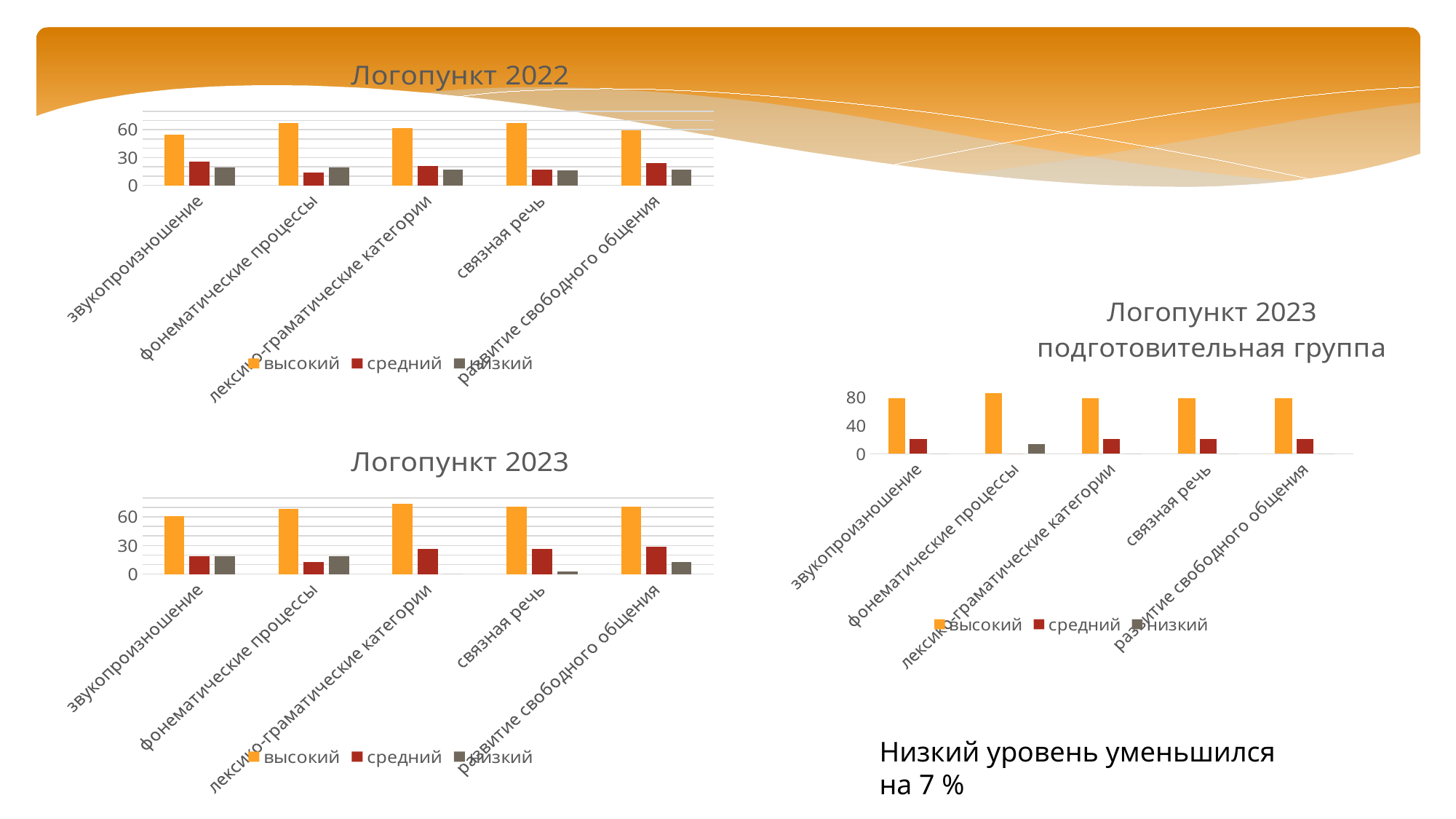
In the "Логопункт 2023 подготовительная группа" chart, which category has the highest "высокий" value? фонематические процессы How many categories are shown on the x axis of the "Логопункт 2023" chart? 5 In the "Логопункт 2022" chart, is the value of "высокий" for "фонематические процессы" greater or less than 60? greater In the "Логопункт 2023" chart, for "фонематические процессы", which is larger: "средний" or "низкий"? низкий In the "Логопункт 2023" chart, which category has the lowest "высокий" value? звукопроизношение What kind of chart is the "Логопункт 2022" chart? bar chart In the "Логопункт 2023" chart, which category has the lowest "низкий" value? лексико-граматические категории In the "Логопункт 2023 подготовительная группа" chart, is the value of "средний" for "звукопроизношение" greater or less than 40? less In the "Логопункт 2022" chart, is the value of "высокий" for "звукопроизношение" greater or less than 60? less In the "Логопункт 2022" chart, for "звукопроизношение", which is larger: "средний" or "низкий"? средний How many series does the legend of the "Логопункт 2023 подготовительная группа" chart list? 3